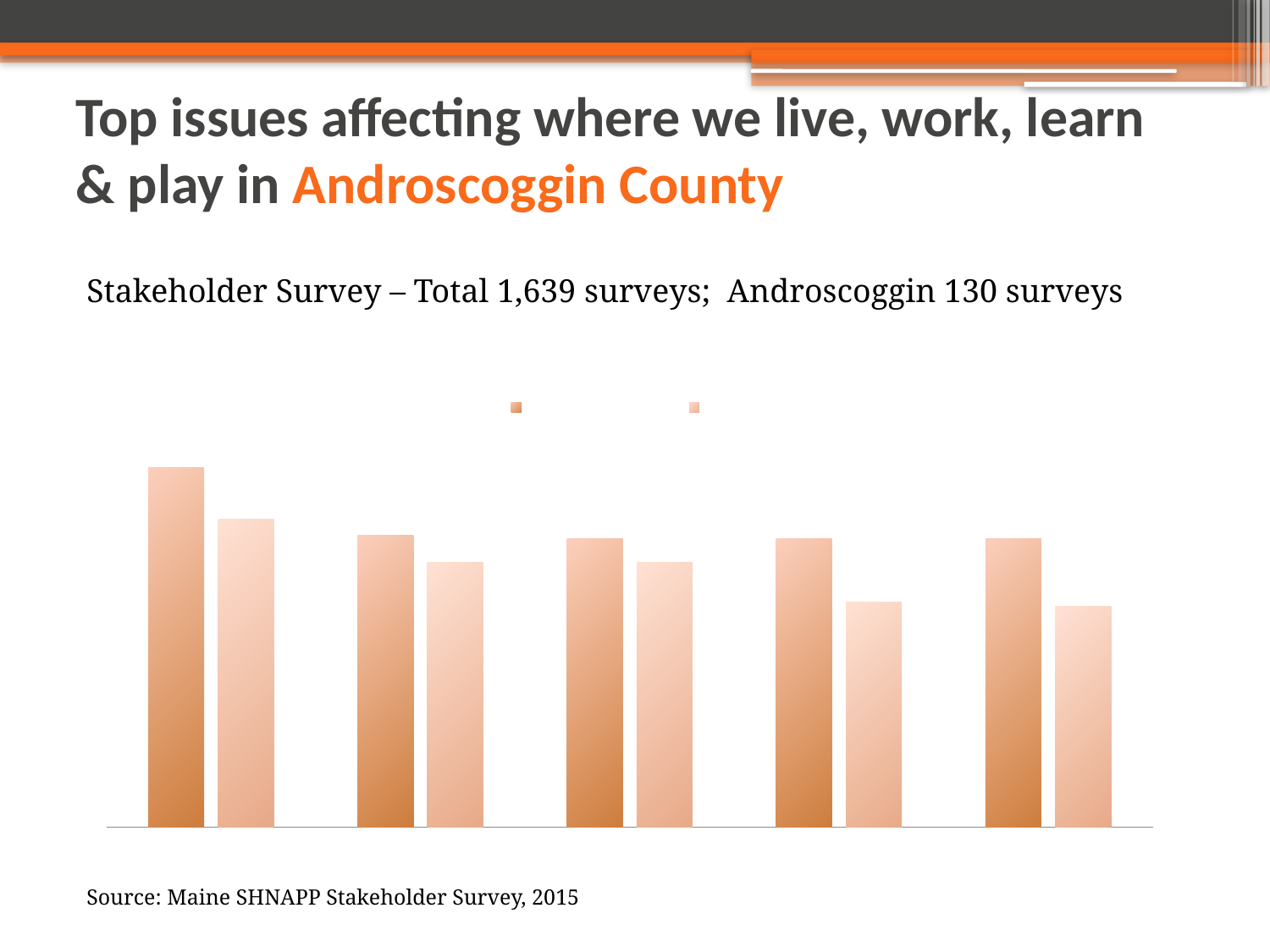
How many bars are plotted in total on the chart? 10 In each group, which bar is taller: the darker orange one or the lighter orange one? the darker orange one What colours are used for the bars in the chart? shades of orange (darker and lighter) How many series does the chart's legend indicate? 2 In the leftmost group of bars, is the darker orange bar or the lighter orange bar taller? the darker orange bar How many groups of bars does the chart show? 5 Which group of bars contains the tallest bar on the chart? the leftmost (first) group In the fourth group of bars from the left, is the darker orange bar or the lighter orange bar taller? the darker orange bar Does the chart display a labelled value axis with numbers? No What kind of chart is shown on the slide? bar chart